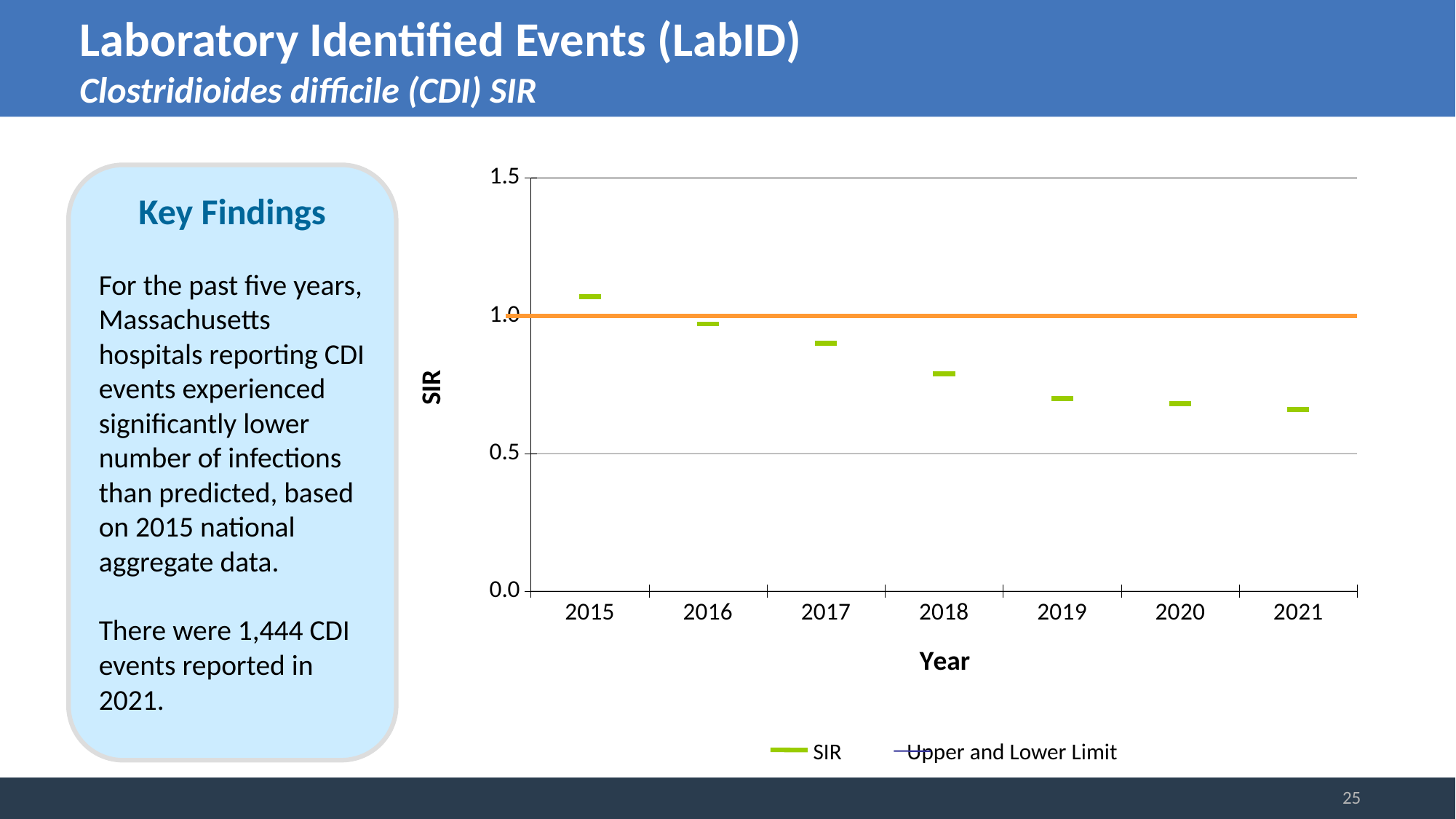
What is the title of the x axis of the chart? Year Is the SIR value for 2021 greater or less than 0.5? greater How many series does the chart legend list? 2 Is the SIR value for 2016 greater or less than 1.0? less What kind of chart is shown on the slide? line chart Is the SIR value for 2018 greater or less than 1.0? less How many years are plotted on the x axis of the chart? 7 Do the SIR values rise or fall from 2015 to 2021? fall Which is larger, the SIR value for 2015 or for 2018? 2015 Which year has the highest SIR value in the chart? 2015